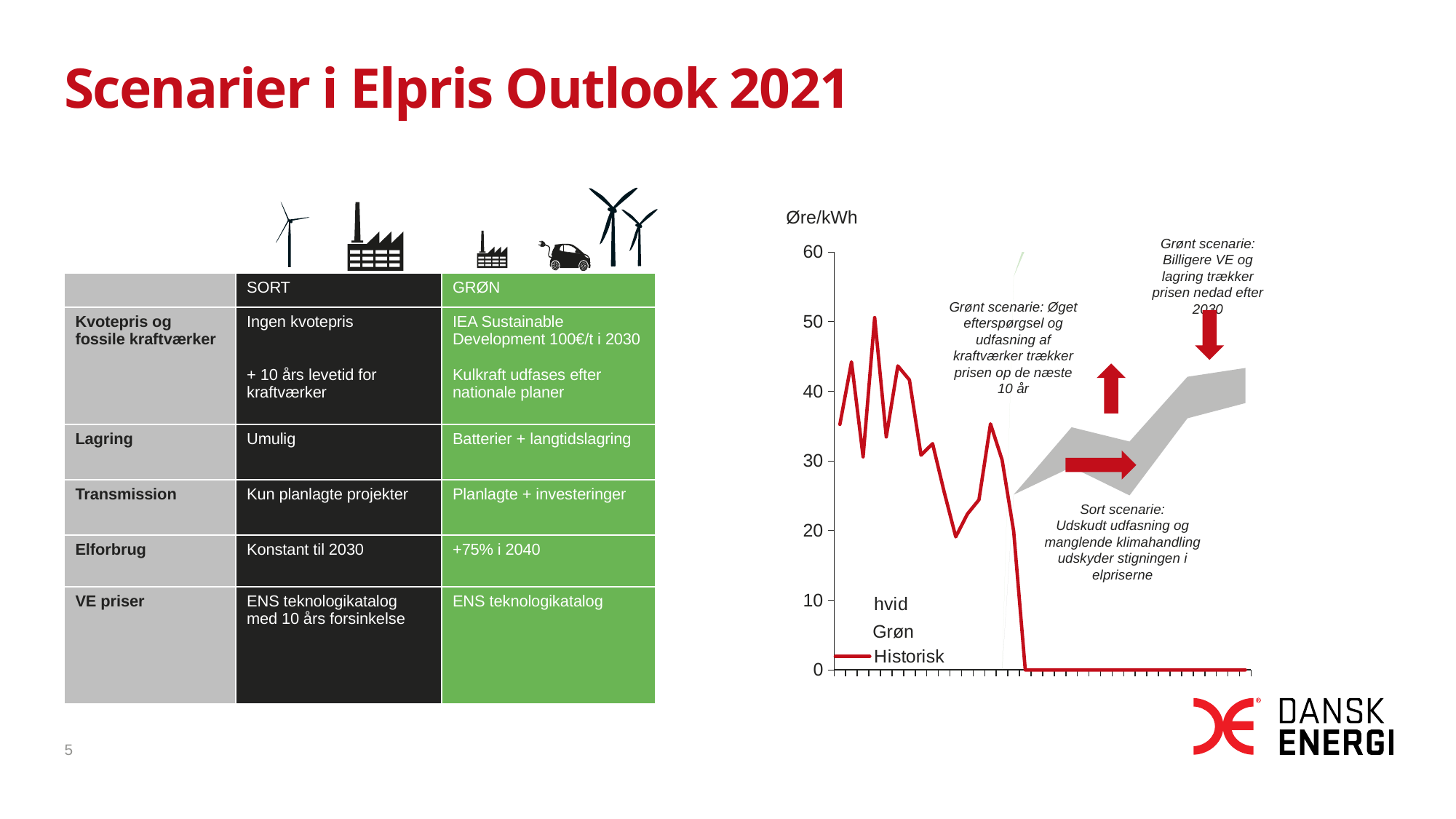
What unit is shown on the y axis of the chart? Øre/kWh Is the highest point of the Historisk line greater or less than 40? greater How many series does the legend of the chart list? 3 Is the highest point of the Historisk line greater or less than 60? less What is the highest tick value shown on the y axis of the chart? 60 Does the Historisk line overall rise or fall from left to right across the chart? fall What kind of chart is shown on the right side of the slide? combination area and line chart Which legend entry is drawn as a red line in the chart? Historisk